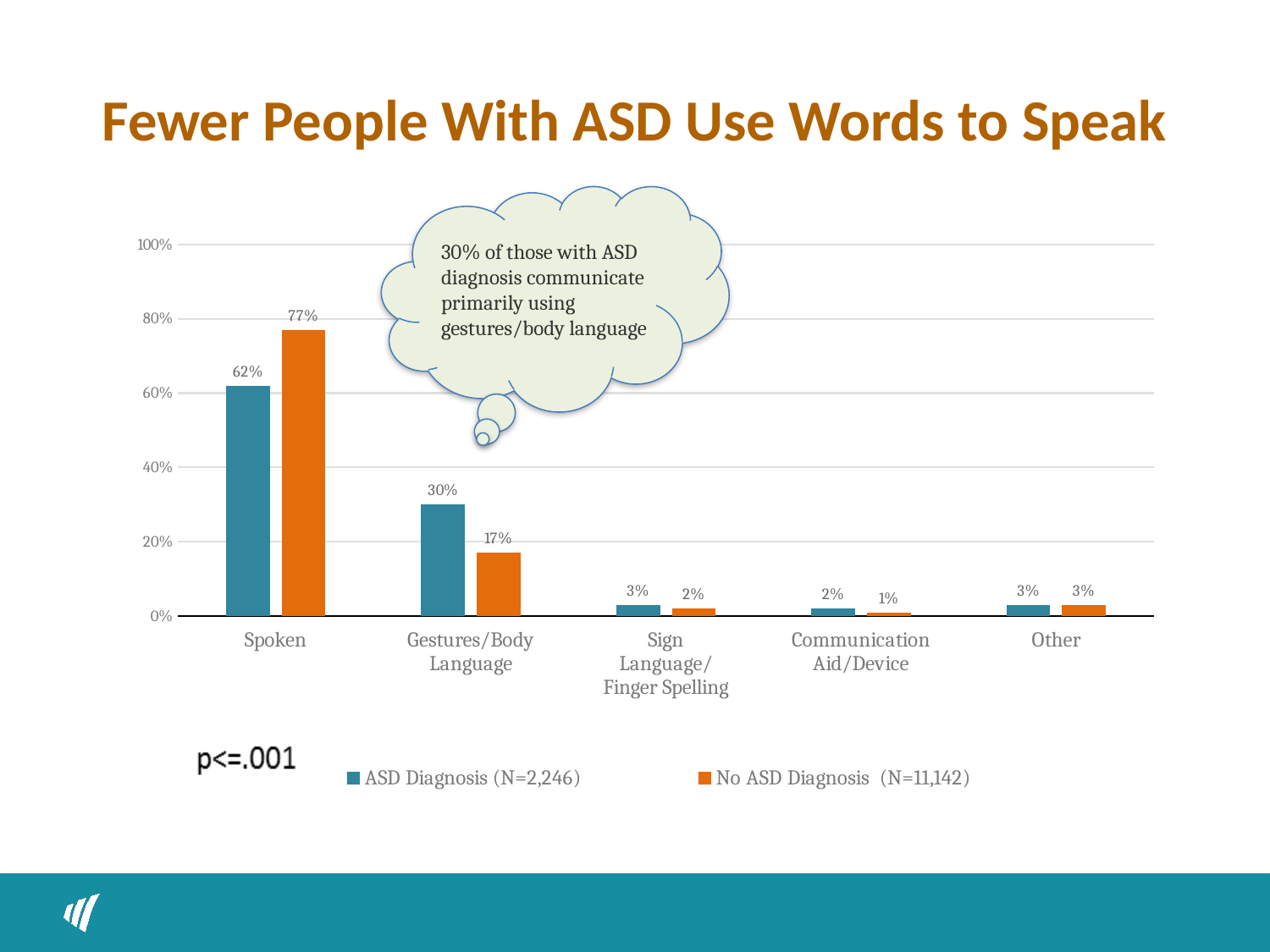
What percentage of people with an ASD diagnosis use spoken communication? 62% How many communication categories are shown on the x axis? 5 How many series does the legend list? 2 Which category has the lowest value for the No ASD Diagnosis series? Communication Aid/Device For Gestures/Body Language, which series has the larger value: ASD Diagnosis or No ASD Diagnosis? ASD Diagnosis What is the difference between the ASD Diagnosis and No ASD Diagnosis values for Gestures/Body Language? 13% What is the difference between the No ASD Diagnosis and ASD Diagnosis values for Spoken? 15% What kind of chart is shown on the slide? Bar chart What percentage of people with no ASD diagnosis communicate using gestures/body language? 17% What is the sample size (N) for the ASD Diagnosis series shown in the legend? 2,246 What is the value for Communication Aid/Device in the No ASD Diagnosis series? 1% Which communication category has the highest value for the ASD Diagnosis series? Spoken